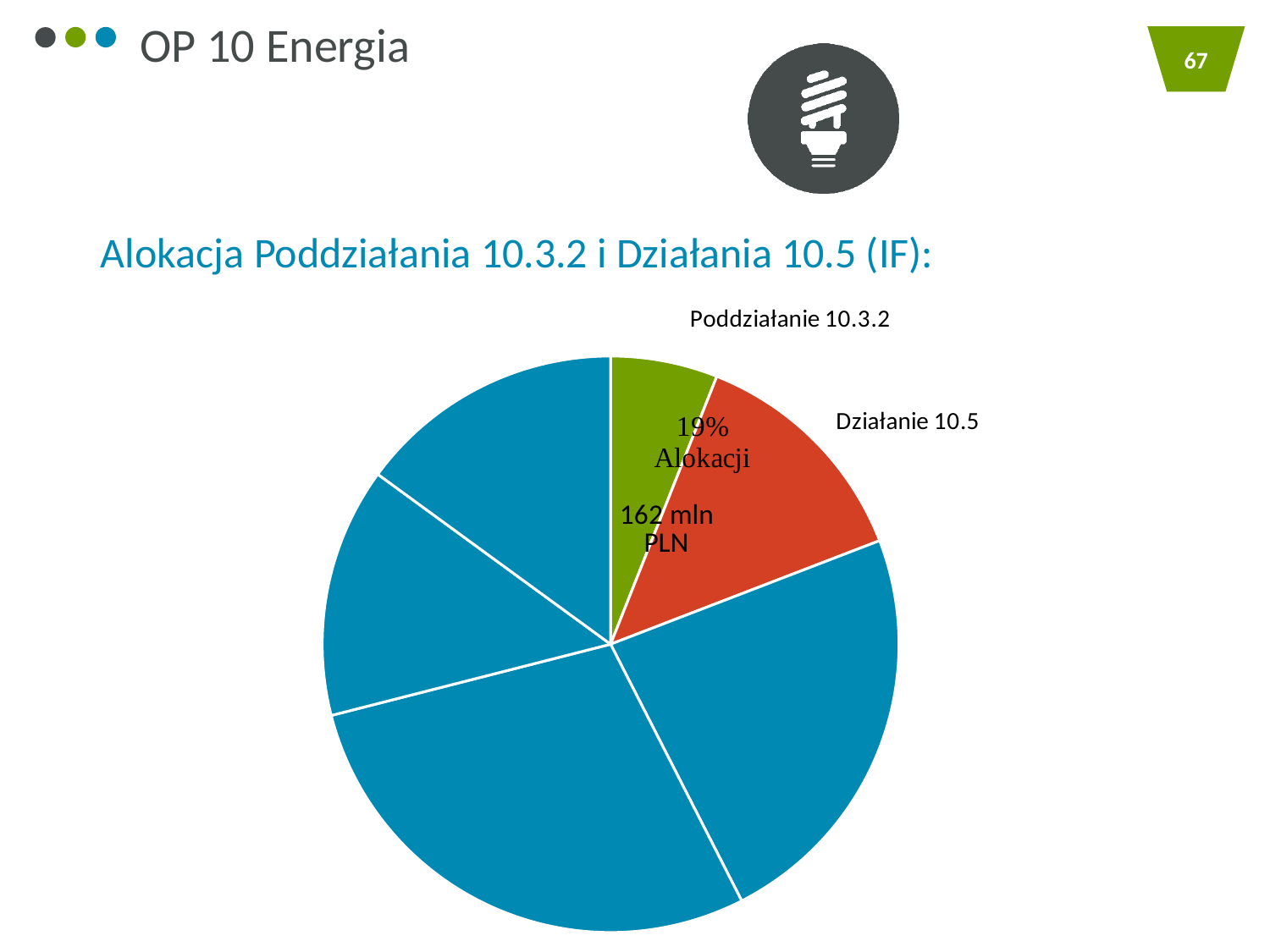
What percentage of the allocation is printed on the pie chart? 19% What kind of chart is shown on the slide? pie chart How many slices of the pie chart are labelled with a name? 2 Which is the smallest slice of the pie chart? Poddziałanie 10.3.2 According to the text on the chart, what share of the allocation do Poddziałanie 10.3.2 and Działanie 10.5 together represent? 19% What amount in PLN is printed on the pie chart? 162 mln PLN What is the heading above the pie chart? Alokacja Poddziałania 10.3.2 i Działania 10.5 (IF): How many slices does the pie chart have? 6 What colour is the Poddziałanie 10.3.2 slice? green Which slice is larger, Poddziałanie 10.3.2 or Działanie 10.5? Działanie 10.5